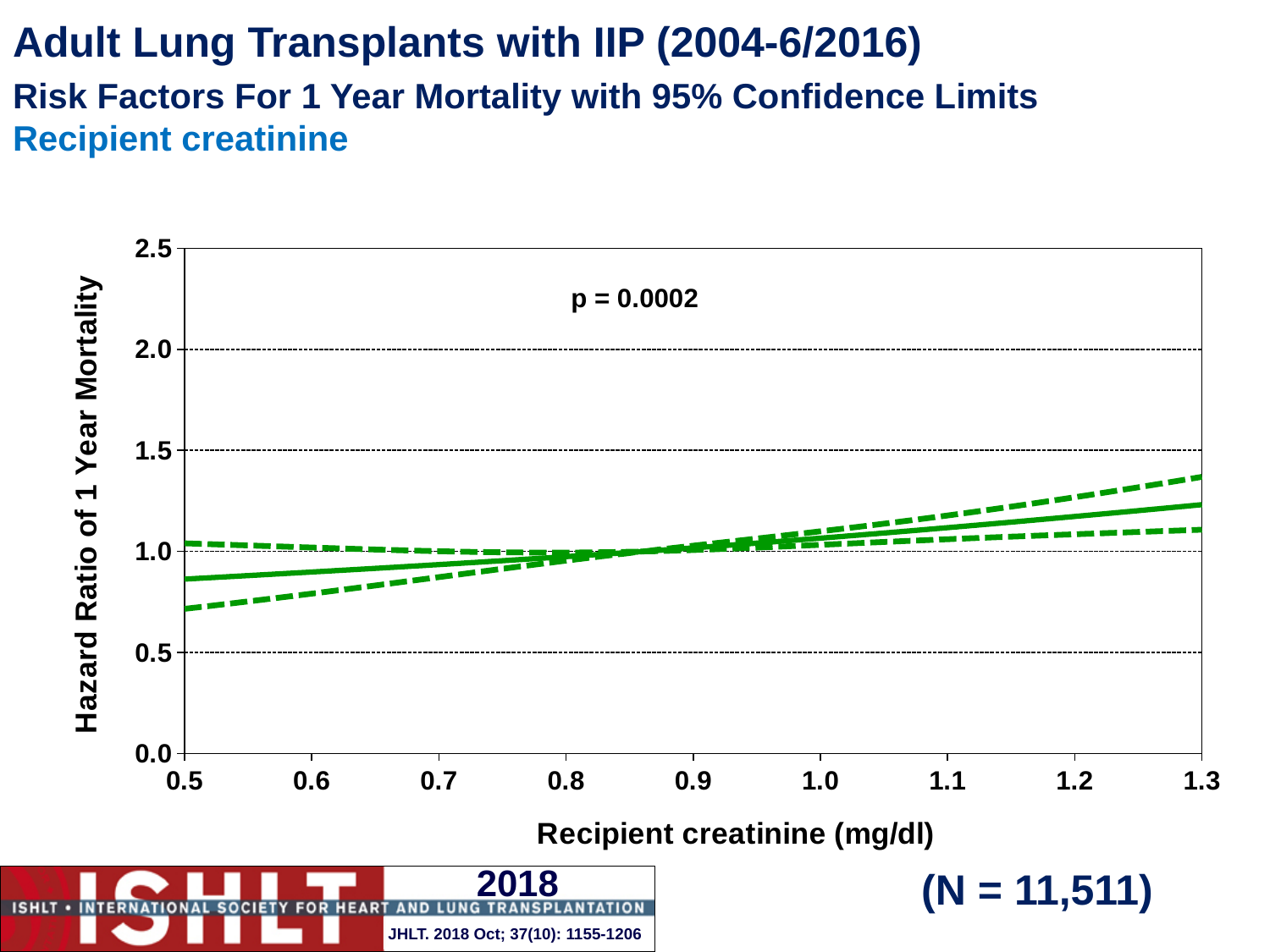
How many tick labels are shown on the x axis of the chart? 9 What sample size (N) is shown on the slide? N = 11,511 What kind of chart is shown on the slide? line chart Is the upper 95% confidence limit (upper dashed line) at a recipient creatinine of 1.3 mg/dl greater or less than 1.5? less How many lines are plotted on the chart? 3 Does the hazard ratio of 1 year mortality (solid line) rise or fall as recipient creatinine increases from 0.5 to 1.3 mg/dl? rise Is the hazard ratio (solid line) at a recipient creatinine of 1.3 mg/dl greater or less than 1.0? greater Is the hazard ratio (solid line) larger at a recipient creatinine of 0.5 mg/dl or at 1.3 mg/dl? 1.3 mg/dl Is the hazard ratio (solid line) at a recipient creatinine of 0.5 mg/dl greater or less than 1.0? less What p-value is printed on the chart? p = 0.0002